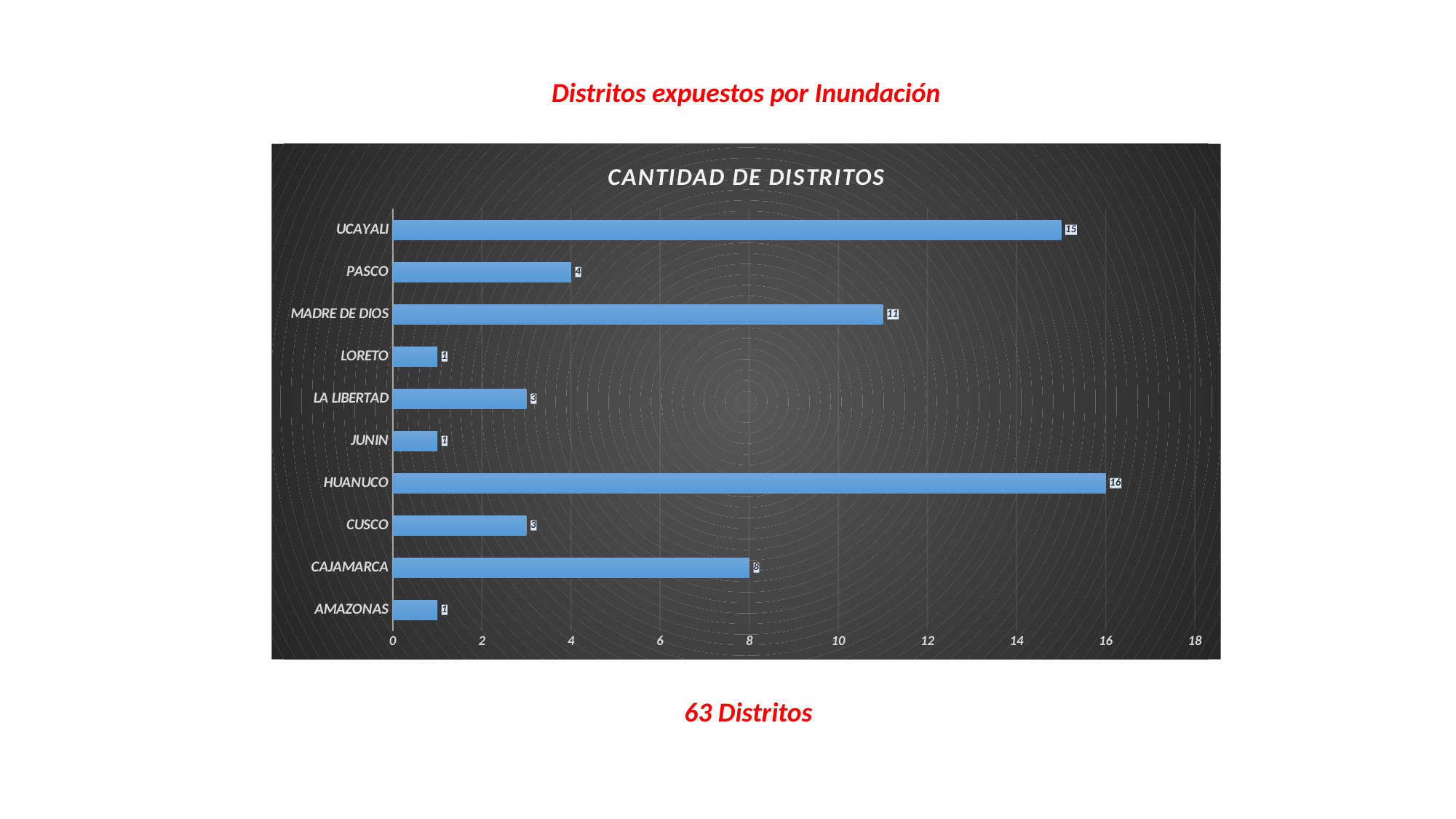
What is the difference between the values for UCAYALI and PASCO? 11 What kind of chart is shown on the slide? bar chart What is the difference between the values for HUANUCO and CAJAMARCA? 8 What is the value for HUANUCO? 16 What is the value for MADRE DE DIOS? 11 How many categories are shown on the chart? 10 What is the value for CAJAMARCA? 8 Is the value for UCAYALI greater or less than 14? greater Which category has the highest value? HUANUCO What is the value for LA LIBERTAD? 3 What is the title of the chart? CANTIDAD DE DISTRITOS Which is larger, the value for MADRE DE DIOS or the value for CAJAMARCA? MADRE DE DIOS